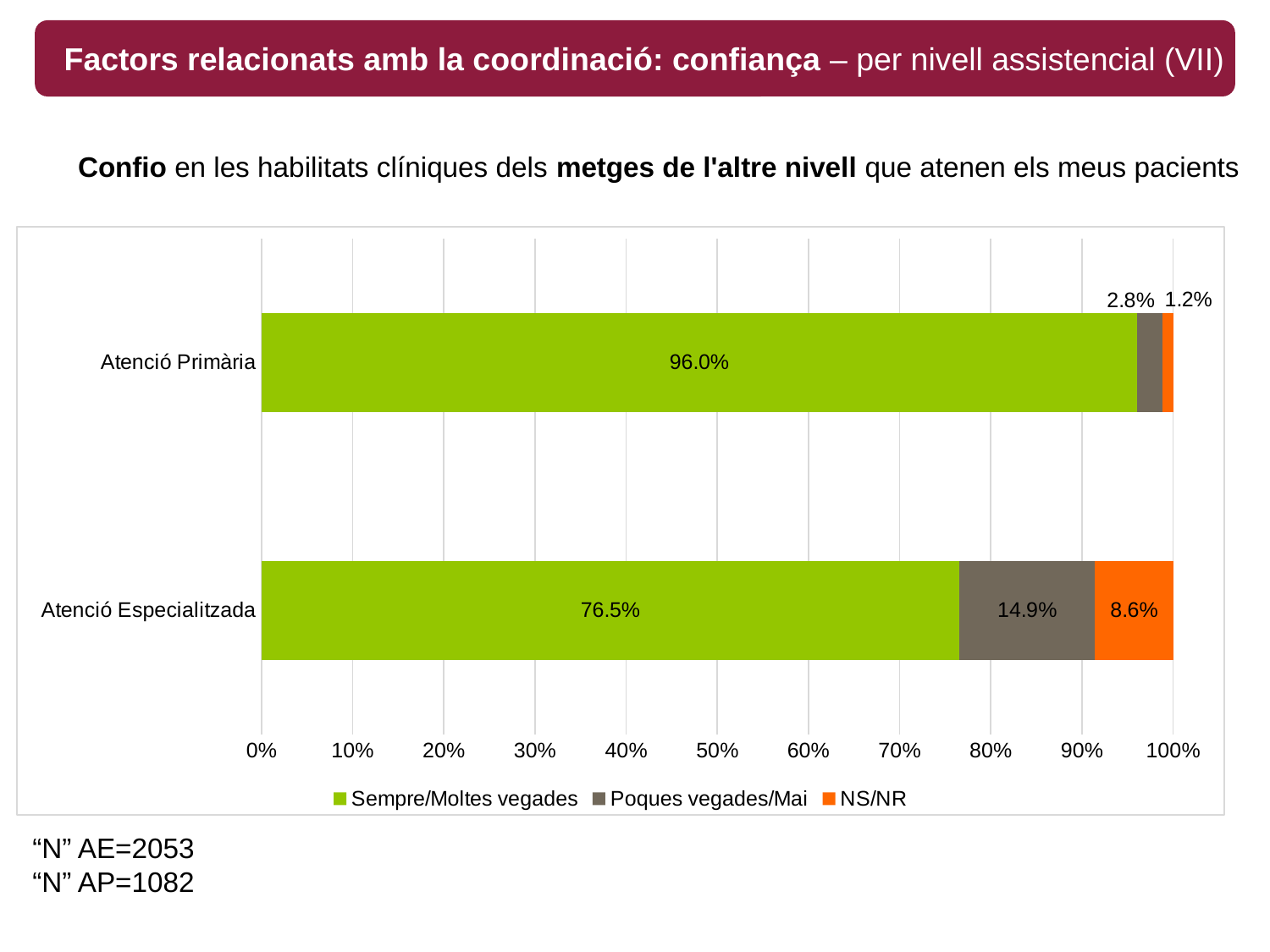
What is the NS/NR value for Atenció Primària? 1.2% What is the NS/NR value for Atenció Especialitzada? 8.6% Which category has the higher Sempre/Moltes vegades value? Atenció Primària Is the NS/NR value larger for Atenció Primària or Atenció Especialitzada? Atenció Especialitzada Which colour represents NS/NR in the legend? Orange How many categories are shown on the y axis? 2 What is the difference between the Sempre/Moltes vegades values for Atenció Primària and Atenció Especialitzada? 19.5% How many series does the legend list? 3 What kind of chart is shown? Stacked bar chart What is the value for Poques vegades/Mai for Atenció Especialitzada? 14.9% What is the value for Sempre/Moltes vegades for Atenció Primària? 96.0% Which category has the lower Poques vegades/Mai value? Atenció Primària